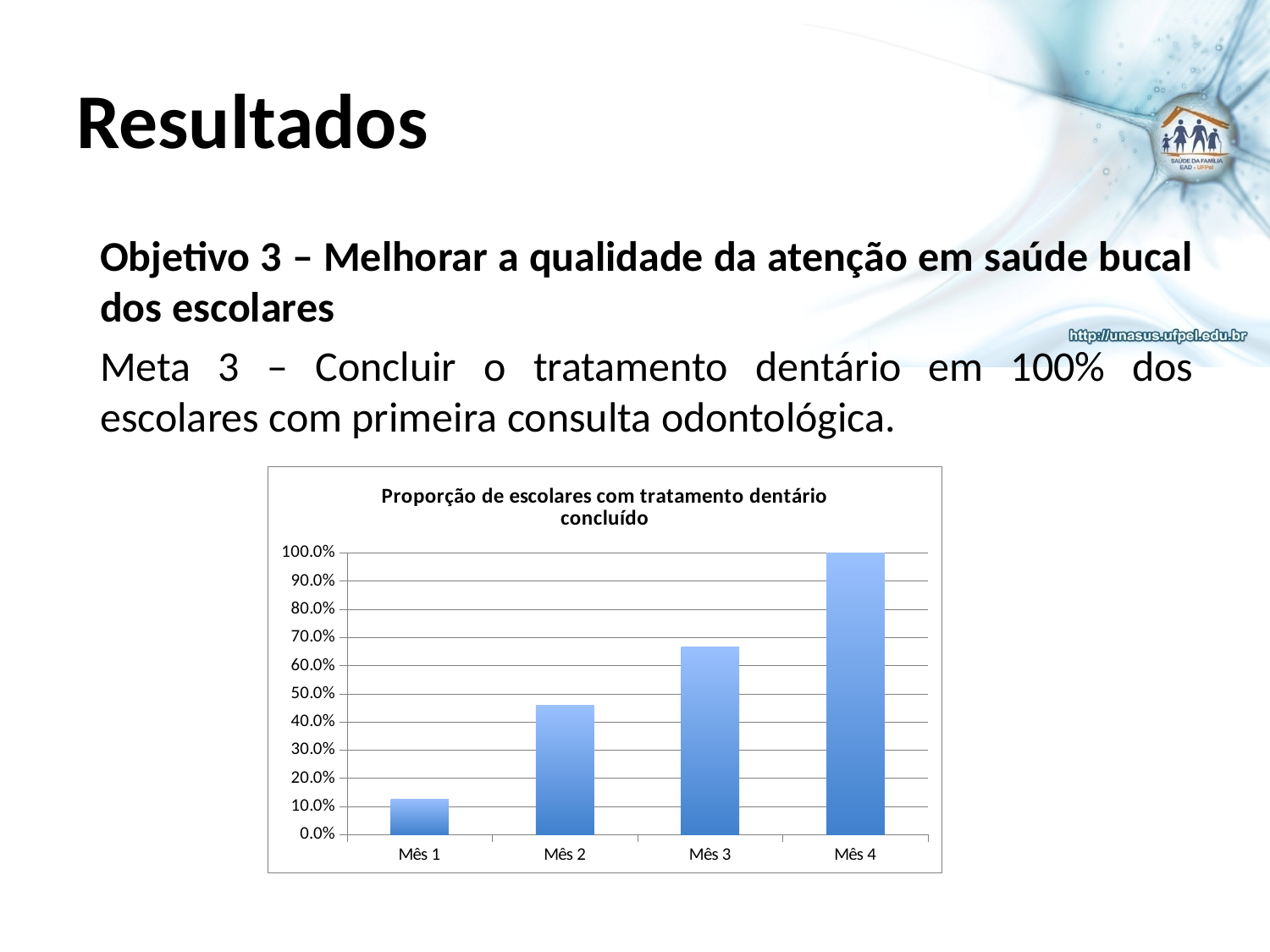
Do the values rise or fall from Mês 1 to Mês 4? rise How many categories (months) are shown on the x axis of the chart? 4 What type of chart is shown on the slide? bar chart What is the highest value shown on the y axis of the chart? 100.0% Which is larger, the value for Mês 2 or the value for Mês 3? Mês 3 Which month has the highest proportion of students with completed dental treatment? Mês 4 Is the value for Mês 2 greater or less than 40.0%? greater Is the value for Mês 1 greater or less than 20.0%? less Which month has the lowest proportion of students with completed dental treatment? Mês 1 Is the value for Mês 3 greater or less than 70.0%? less What is the value for Mês 4 in the chart? 100.0% What is the title of the chart? Proporção de escolares com tratamento dentário concluído